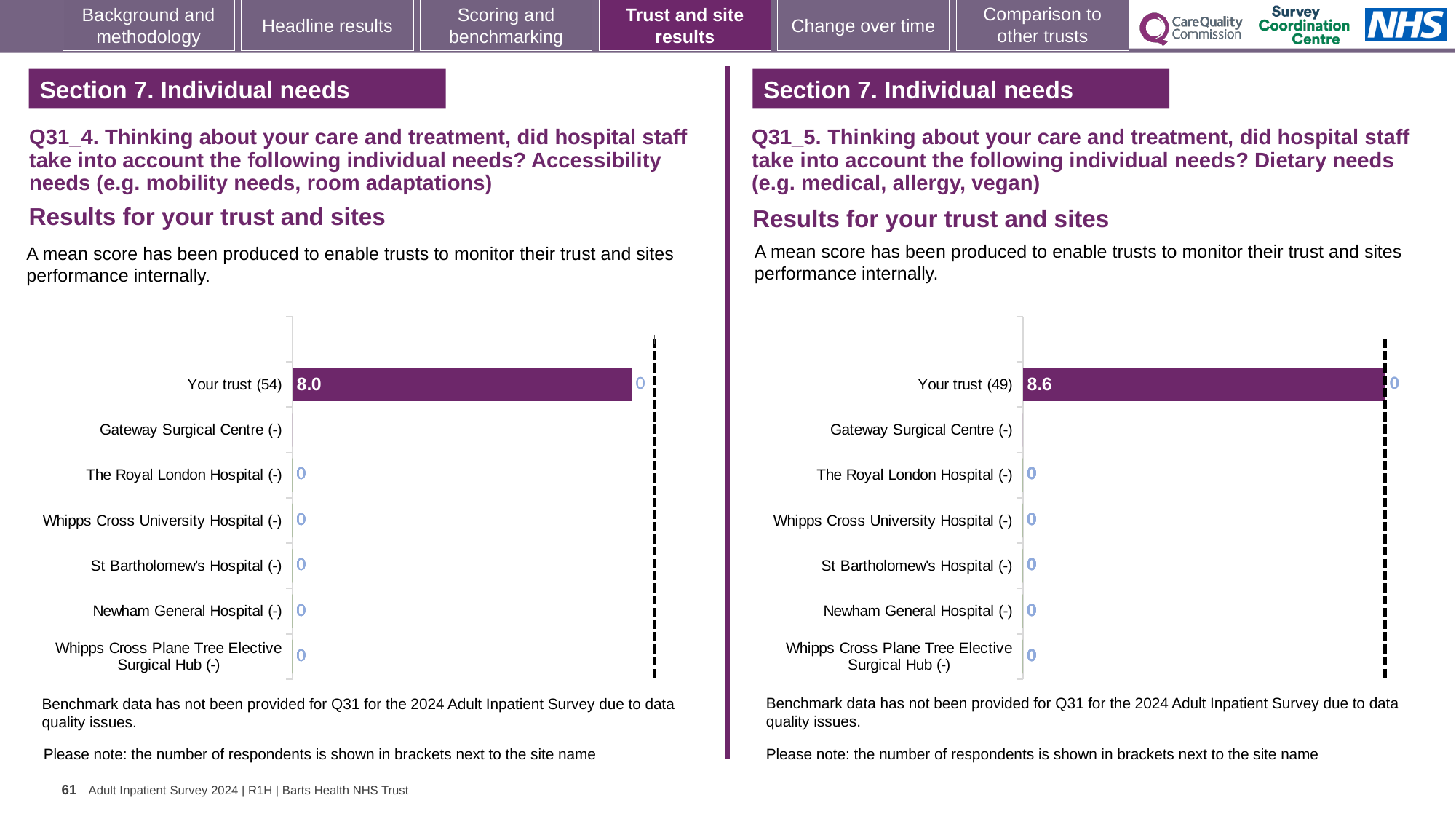
Which section do both charts on the slide belong to? Section 7. Individual needs In the right chart (Q31_5), how many respondents are shown in brackets for Your trust? 49 What is the difference between the Your trust mean score in the right chart (Q31_5) and in the left chart (Q31_4)? 0.6 In the right chart (Q31_5), which category is the only one with a plotted bar? Your trust (49) In the left chart (Q31_4, accessibility needs), what is the mean score for Your trust? 8.0 In the left chart (Q31_4), which category is the only one with a plotted bar? Your trust (54) How many categories (trust and sites) are listed on the right chart (Q31_5)? 7 What type of chart is used in the left chart (Q31_4)? bar chart In the left chart (Q31_4), how many respondents are shown in brackets for Your trust? 54 In the right chart (Q31_5, dietary needs), what is the mean score for Your trust? 8.6 Which chart shows the higher mean score for Your trust: the left chart (Q31_4) or the right chart (Q31_5)? the right chart (Q31_5) How many categories (trust and sites) are listed on the left chart (Q31_4)? 7